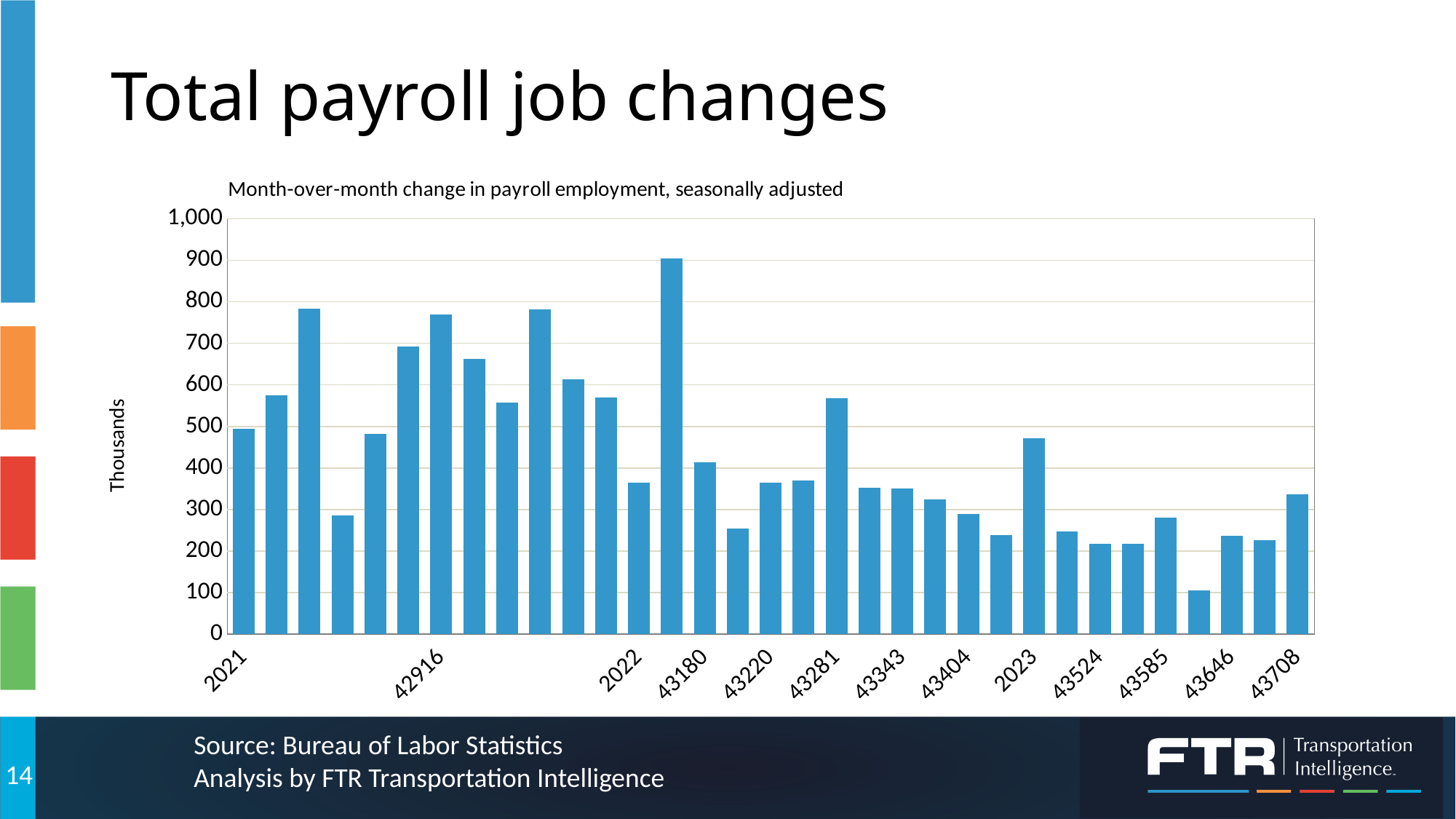
What kind of chart is shown on the slide? bar chart Which is larger, the value for 42916 or the value for 43646? 42916 What is the subtitle printed above the chart? Month-over-month change in payroll employment, seasonally adjusted Is the value for 43281 greater or less than 500? greater What is the label on the vertical axis of the chart? Thousands Overall, do the values rise or fall from 2021 to 2023 along the x axis? fall Is the value for 42916 greater or less than 700? greater Is the value for 43343 greater or less than 400? less